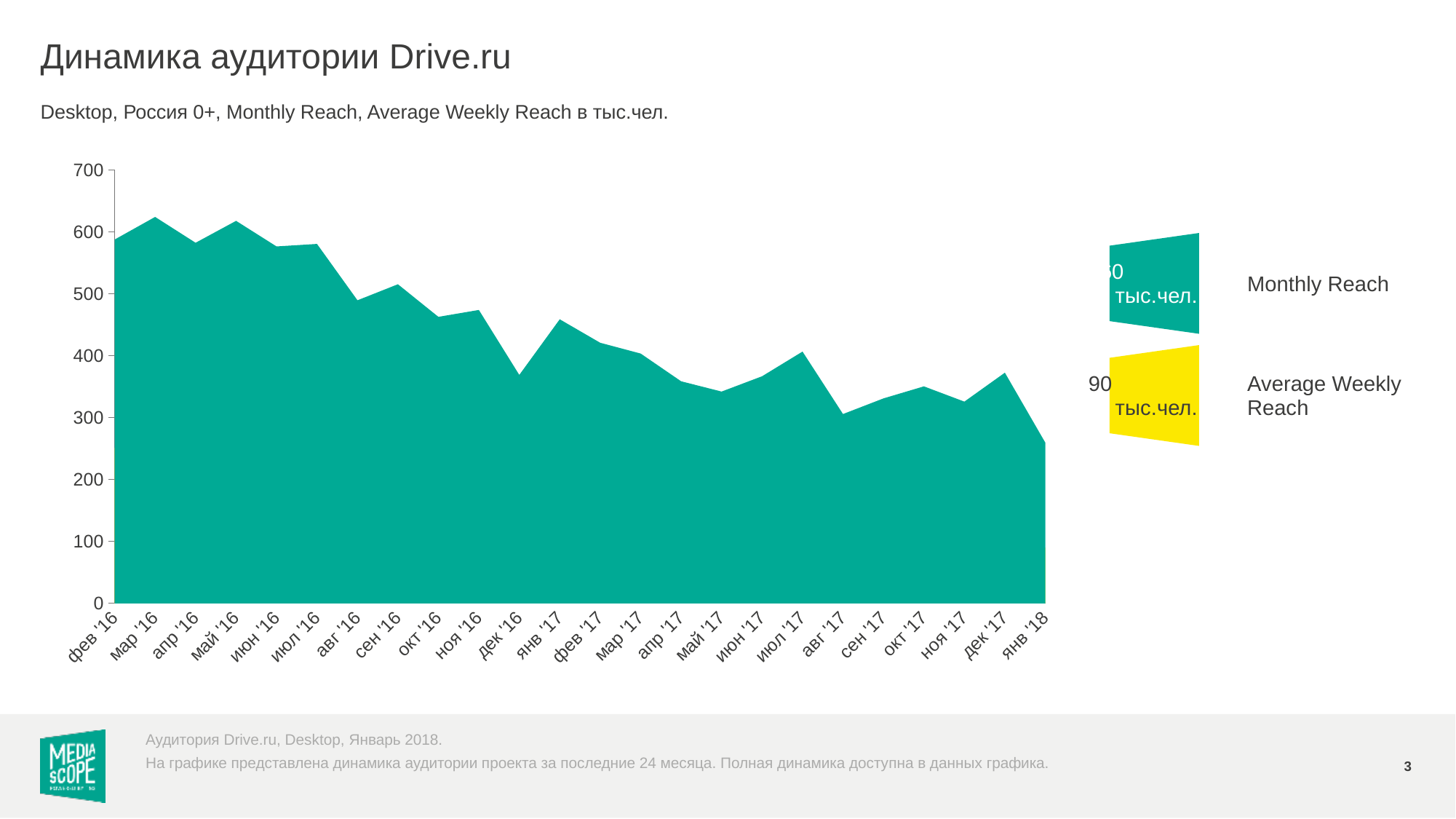
Which month has the lowest Monthly Reach value? янв '18 What kind of chart is shown on the slide? area chart Which is larger, the Monthly Reach for фев '16 or for янв '18? фев '16 How many monthly points are plotted along the x axis? 24 What is the title of the slide? Динамика аудитории Drive.ru Is the Monthly Reach value for авг '17 greater or less than 400? less Is the Monthly Reach value for дек '16 greater or less than 400? less Which is larger, the Monthly Reach for дек '16 or for янв '17? янв '17 Is the Monthly Reach value for янв '18 greater or less than 300? less Overall, do the Monthly Reach values rise or fall from фев '16 to янв '18? fall